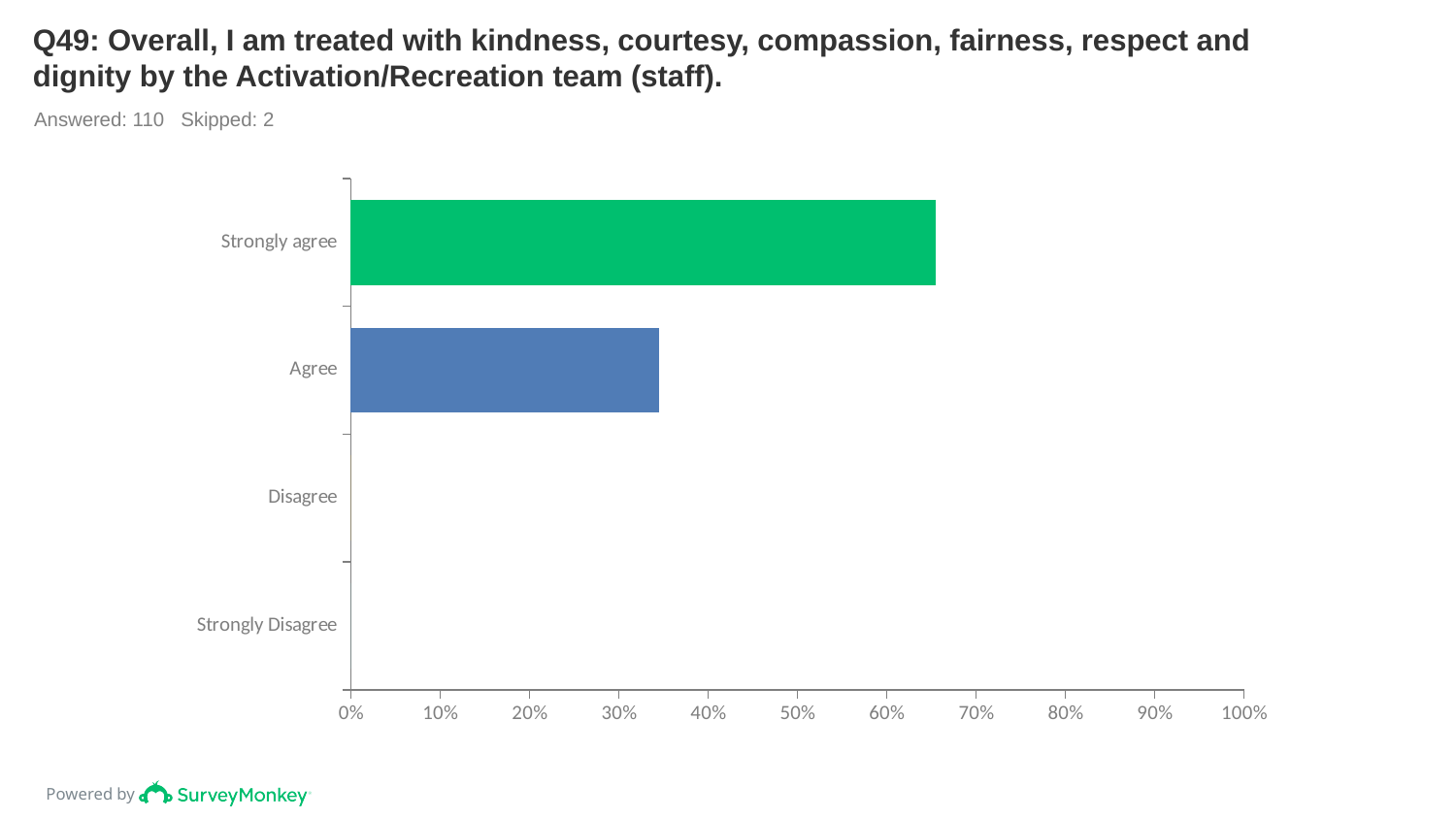
How many respondents answered this question according to the slide? 110 What is the highest value shown on the horizontal axis? 100% What is the value for Disagree? 0% Which response category has the highest value? Strongly agree Which is larger, the value for Strongly agree or the value for Agree? Strongly agree Is the value for Strongly agree greater or less than 50%? greater Is the value for Agree greater or less than 30%? greater What kind of chart is shown on the slide? Bar chart Is the value for Agree greater or less than 40%? less How many response categories are shown on the chart? 4